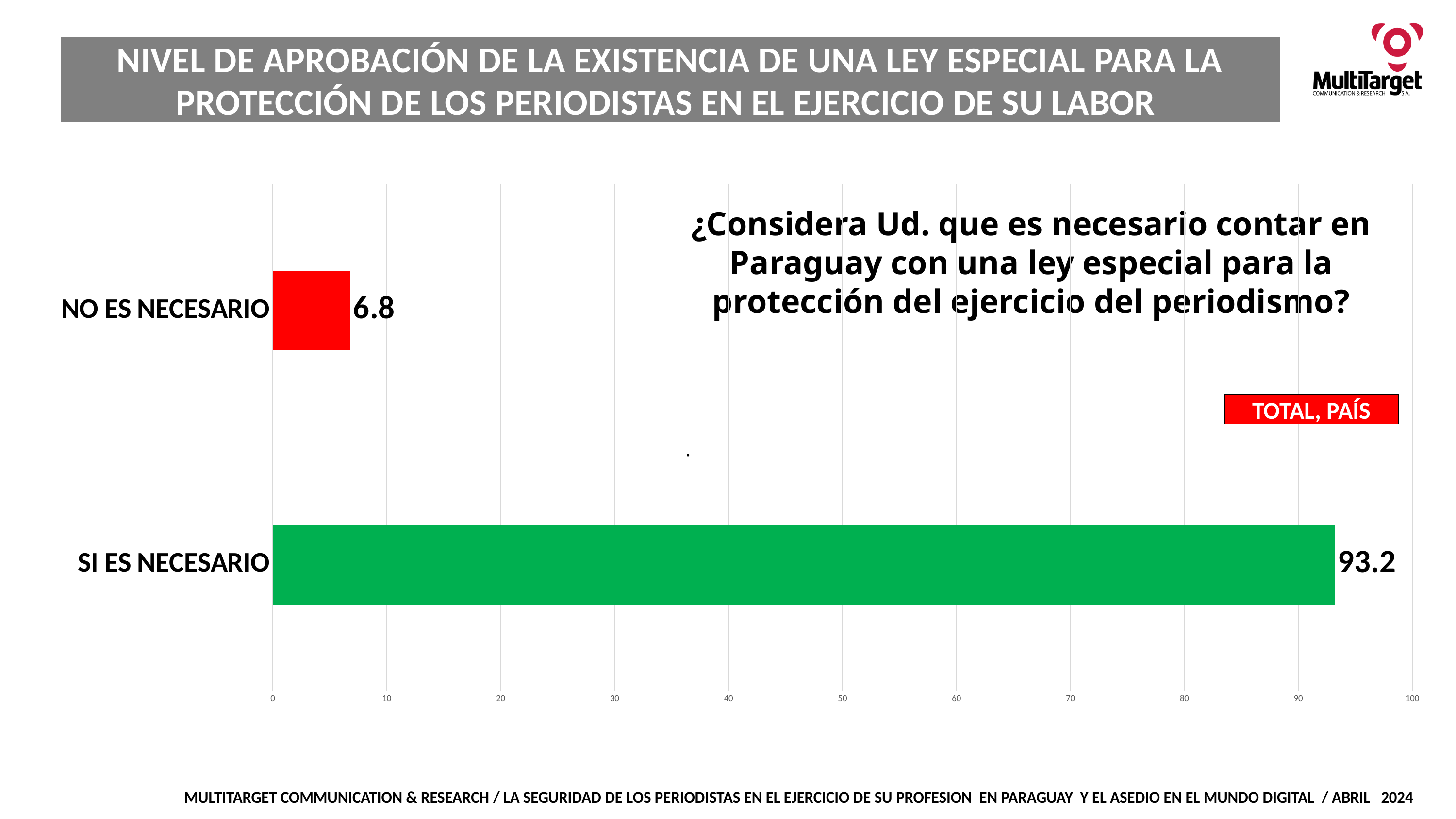
Which is larger, the value for SI ES NECESARIO or the value for NO ES NECESARIO? SI ES NECESARIO What is the total of the two values shown in the chart? 100 What kind of chart is shown on the slide? bar chart What is the difference between the values for SI ES NECESARIO and NO ES NECESARIO? 86.4 Which category has the lowest value? NO ES NECESARIO Is the value for NO ES NECESARIO greater or less than 10? less Is the value for SI ES NECESARIO greater or less than 90? greater What is the value for NO ES NECESARIO? 6.8 What colour is the bar for SI ES NECESARIO? green What is the value for SI ES NECESARIO? 93.2 How many categories are shown in the chart? 2 Which category has the highest value? SI ES NECESARIO